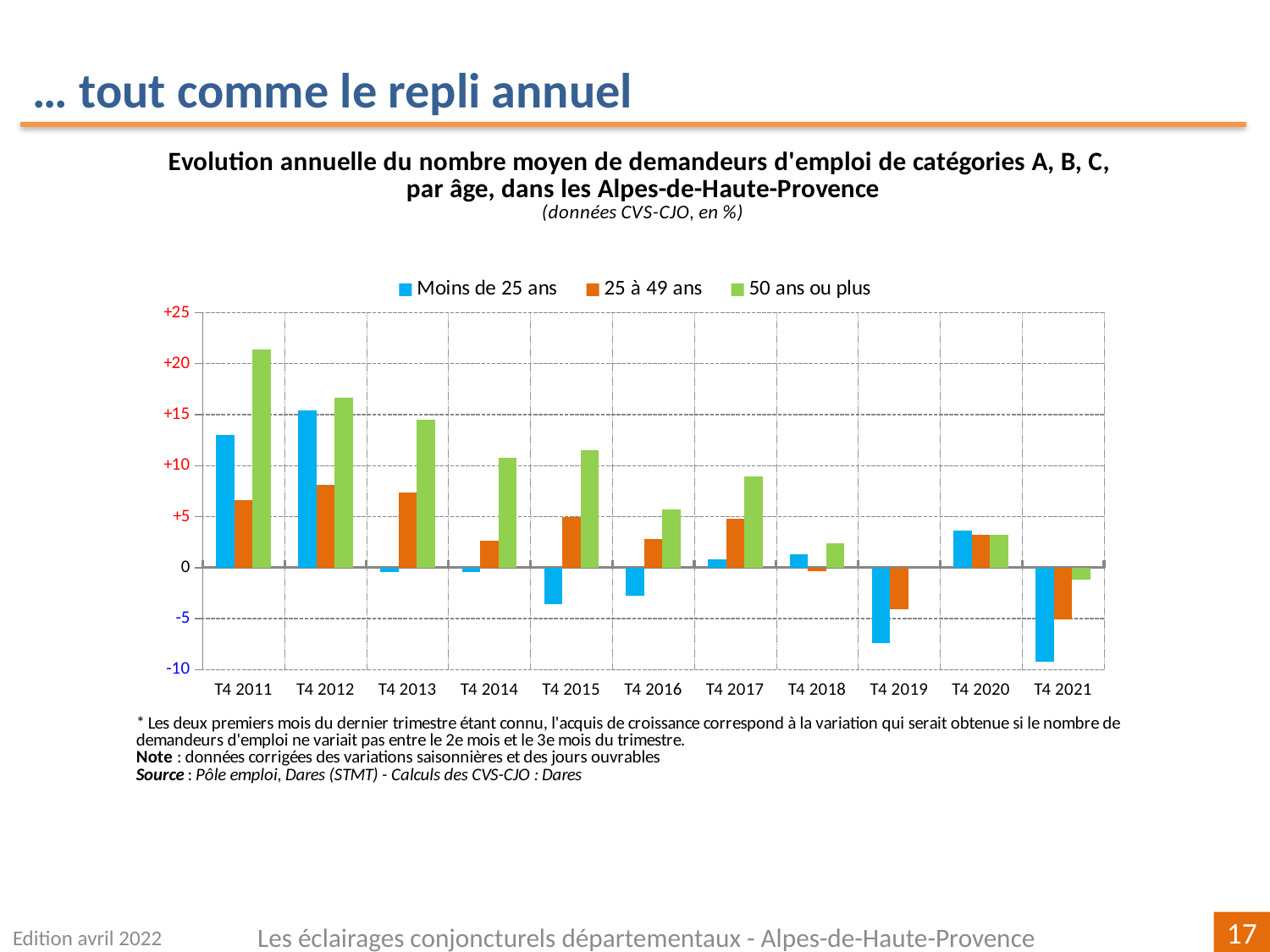
In which quarter is the value for 'Moins de 25 ans' the lowest? T4 2021 Is the value for '50 ans ou plus' in T4 2014 greater or less than +10? greater Which series are listed in the legend? Moins de 25 ans, 25 à 49 ans, 50 ans ou plus Which series has the highest value in T4 2011? 50 ans ou plus Is the value for 'Moins de 25 ans' in T4 2019 greater or less than -5? less In T4 2012, which is larger: the value for 'Moins de 25 ans' or for '25 à 49 ans'? Moins de 25 ans How many quarters (categories) are shown on the x axis? 11 In T4 2013, which is larger: the value for '25 à 49 ans' or for '50 ans ou plus'? 50 ans ou plus What kind of chart is shown on the slide? bar chart In which quarter is the value for '50 ans ou plus' the highest? T4 2011 Is the value for '50 ans ou plus' in T4 2011 greater or less than +20? greater How many series does the legend list? 3